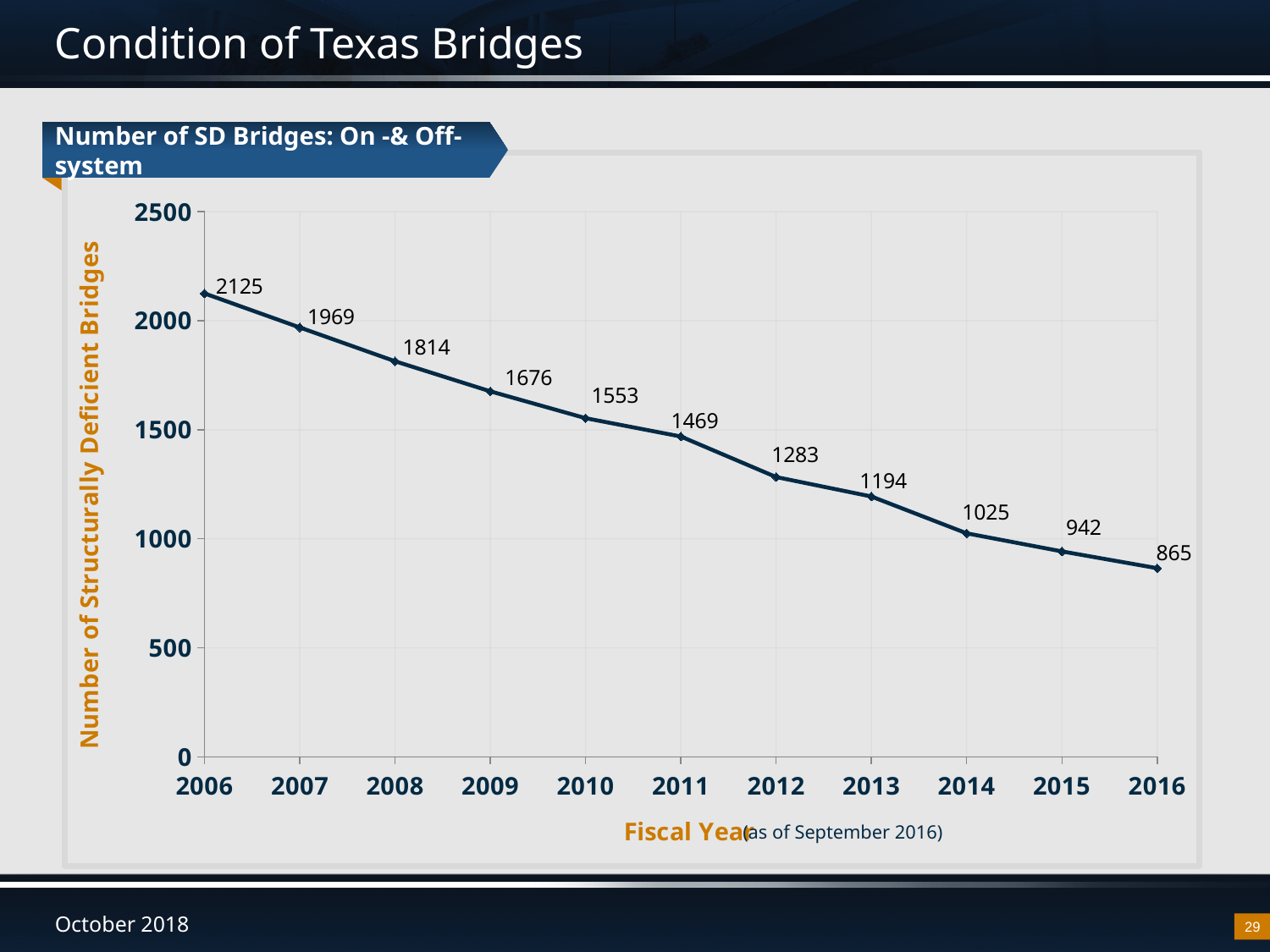
Which fiscal year has the lowest number of structurally deficient bridges? 2016 Which fiscal year has the highest number of structurally deficient bridges? 2006 How many fiscal years are plotted on the chart? 11 What is the number of structurally deficient bridges in 2012? 1283 What is the difference between the number of structurally deficient bridges in 2006 and 2016? 1260 Is the value for 2014 greater or less than 1000? greater Which year has a larger value, 2009 or 2013? 2009 Do the values rise or fall from 2006 to 2016? fall What is the number of structurally deficient bridges in 2006? 2125 What is the difference between the values for 2010 and 2011? 84 What kind of chart is shown on the slide? line chart What is the number of structurally deficient bridges in 2016? 865